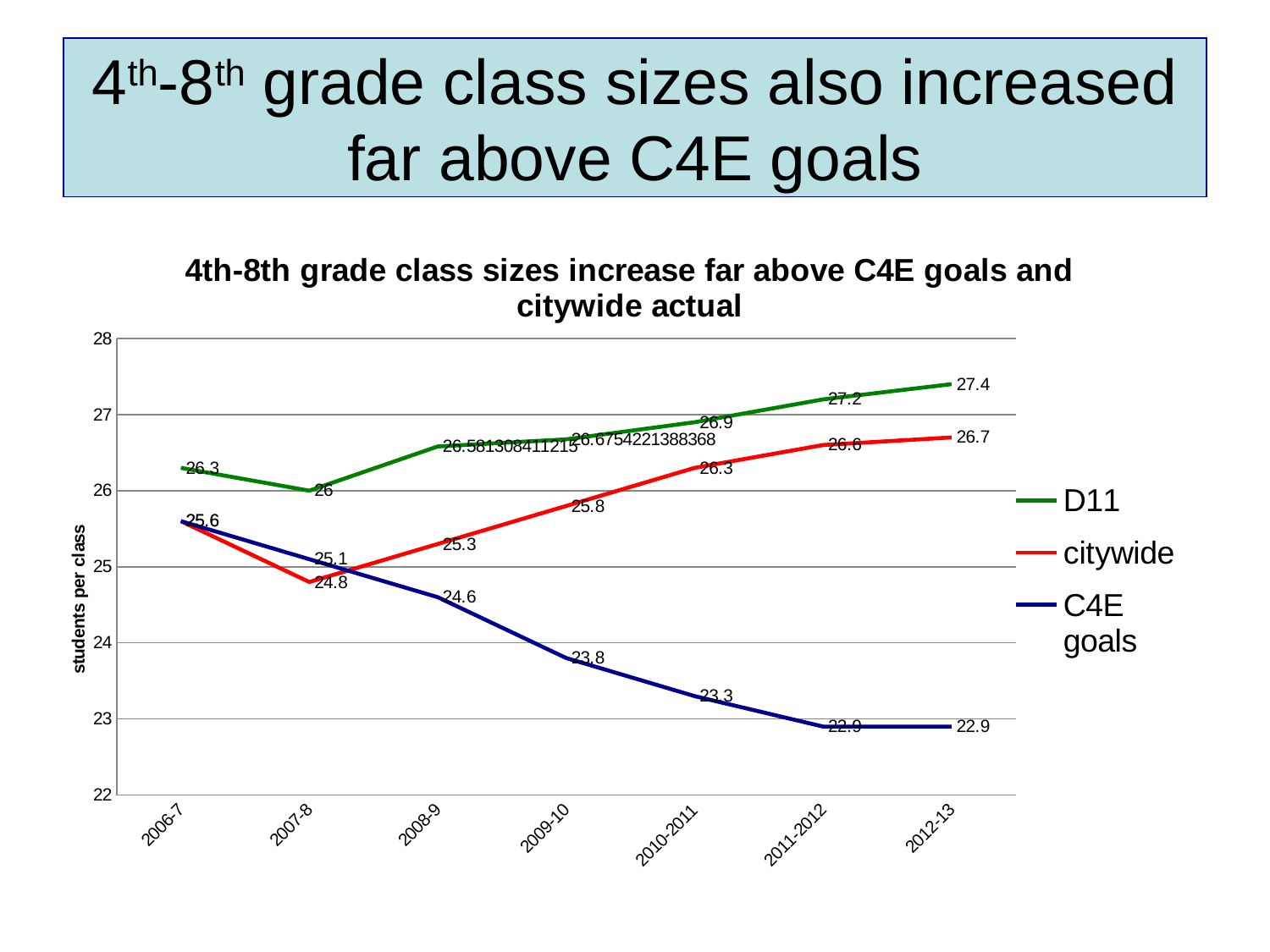
How many series does the legend list? 3 How many school years are plotted on the x axis? 7 What kind of chart is shown on the slide? line chart In which year is the D11 series at its highest? 2012-13 What is the citywide value for 2007-8? 24.8 What is the C4E goals value for 2009-10? 23.8 What is the difference between the D11 value and the C4E goals value in 2012-13? 4.5 Do the C4E goals values rise or fall from 2006-7 to 2012-13? fall In which year is the citywide series at its lowest? 2007-8 By how much did the citywide value change from 2006-7 to 2012-13? 1.1 In 2010-2011, which is larger: the D11 value or the citywide value? D11 What is the D11 value for 2012-13? 27.4